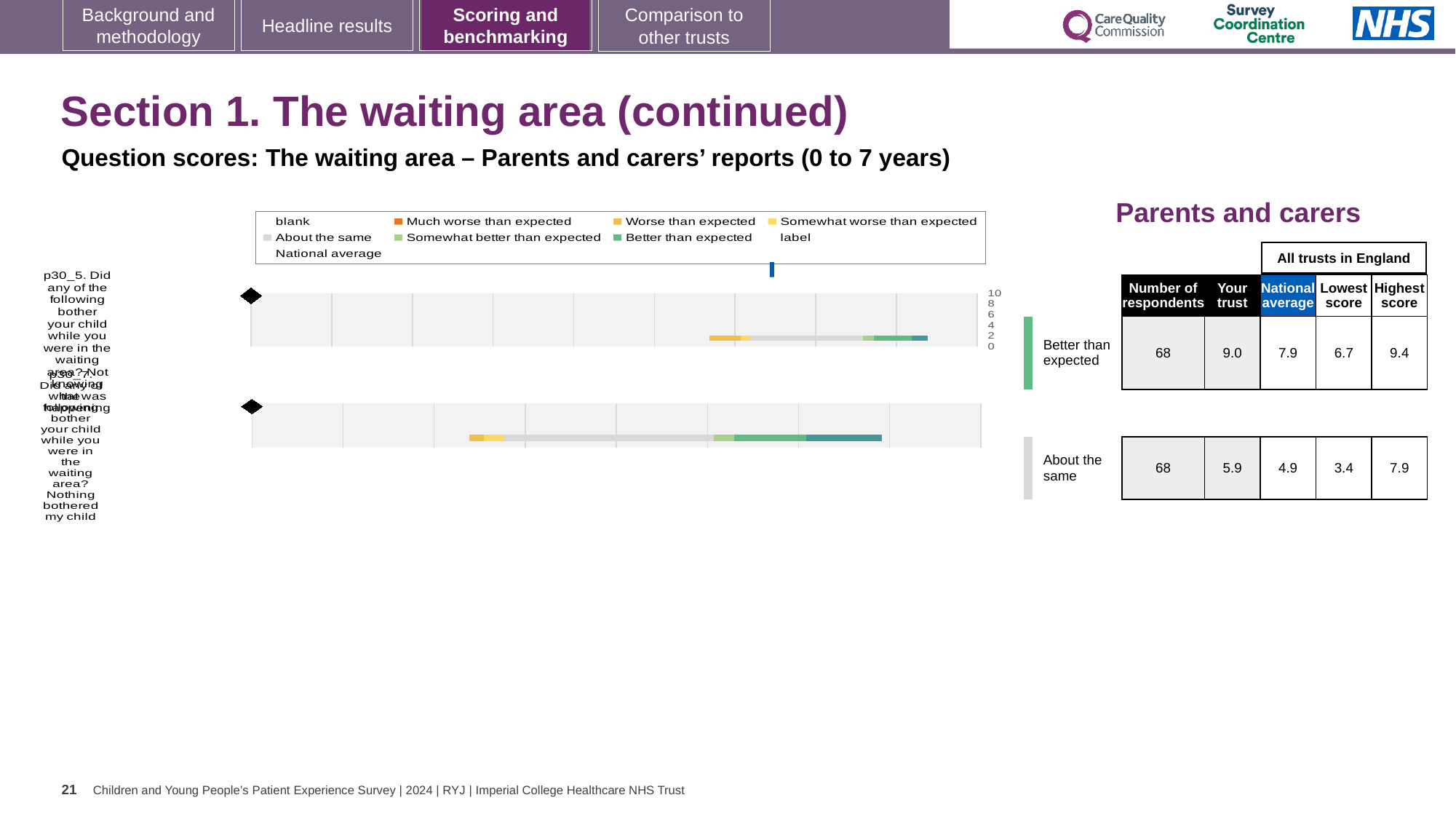
How many bars (question rows) does the chart show? 2 In the table, what is the national average for the question rated 'Better than expected'? 7.9 In the table, what is the lowest score across all trusts in England for the question rated 'Better than expected'? 6.7 In the table, which question has the higher 'Your trust' score: the one rated 'Better than expected' or the one rated 'About the same'? Better than expected Which legend entry is shown in orange? Much worse than expected What kind of chart is shown on the slide? bar chart What is the highest value shown on the chart's axis? 10 In the table, what is the difference between the 'Your trust' score and the national average for the question rated 'About the same'? 1.0 In the table, what is the 'Your trust' score for the question rated 'About the same'? 5.9 In the table, what is the 'Your trust' score for the question rated 'Better than expected'? 9.0 In the table, what is the number of respondents for the question rated 'About the same'? 68 In the table, what is the highest score across all trusts in England for the question rated 'About the same'? 7.9